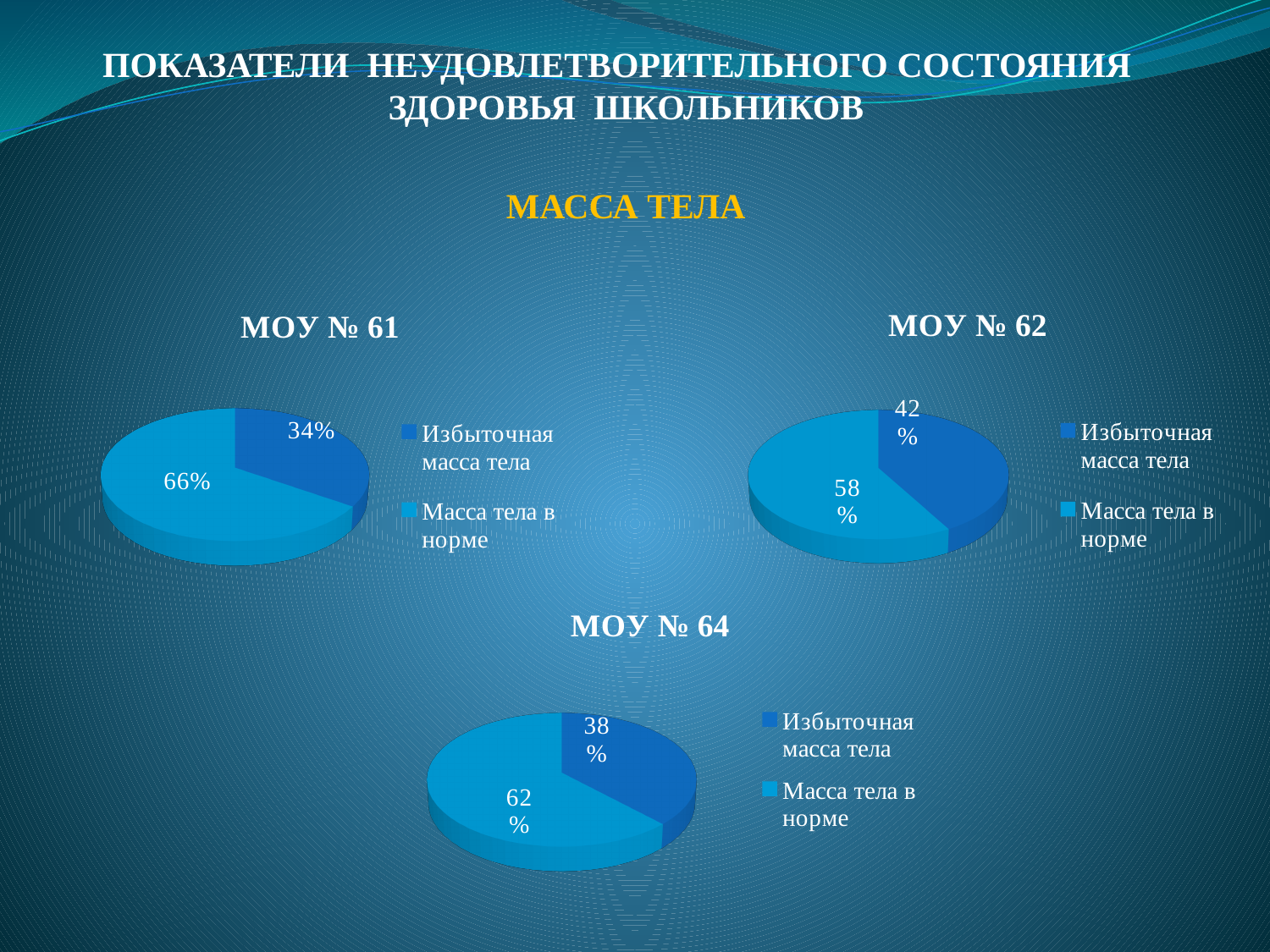
How many entries does the legend of the МОУ № 64 chart list? 2 In the МОУ № 64 chart, what share is labelled for Избыточная масса тела? 38% In the МОУ № 64 chart, which category has the smallest slice? Избыточная масса тела In the МОУ № 62 chart, which slice is larger: Избыточная масса тела or Масса тела в норме? Масса тела в норме What kind of chart is the МОУ № 61 chart? Pie chart In the МОУ № 61 chart, what share is labelled for Масса тела в норме? 66% How many slices does the МОУ № 62 pie chart have? 2 In the МОУ № 64 chart, what share is labelled for Масса тела в норме? 62% In the МОУ № 62 chart, what share is labelled for Избыточная масса тела? 42% In the МОУ № 61 chart, what is the difference between the Масса тела в норме share and the Избыточная масса тела share? 32% In the МОУ № 62 chart, what share is labelled for Масса тела в норме? 58% In the МОУ № 61 chart, what share is labelled for Избыточная масса тела? 34%